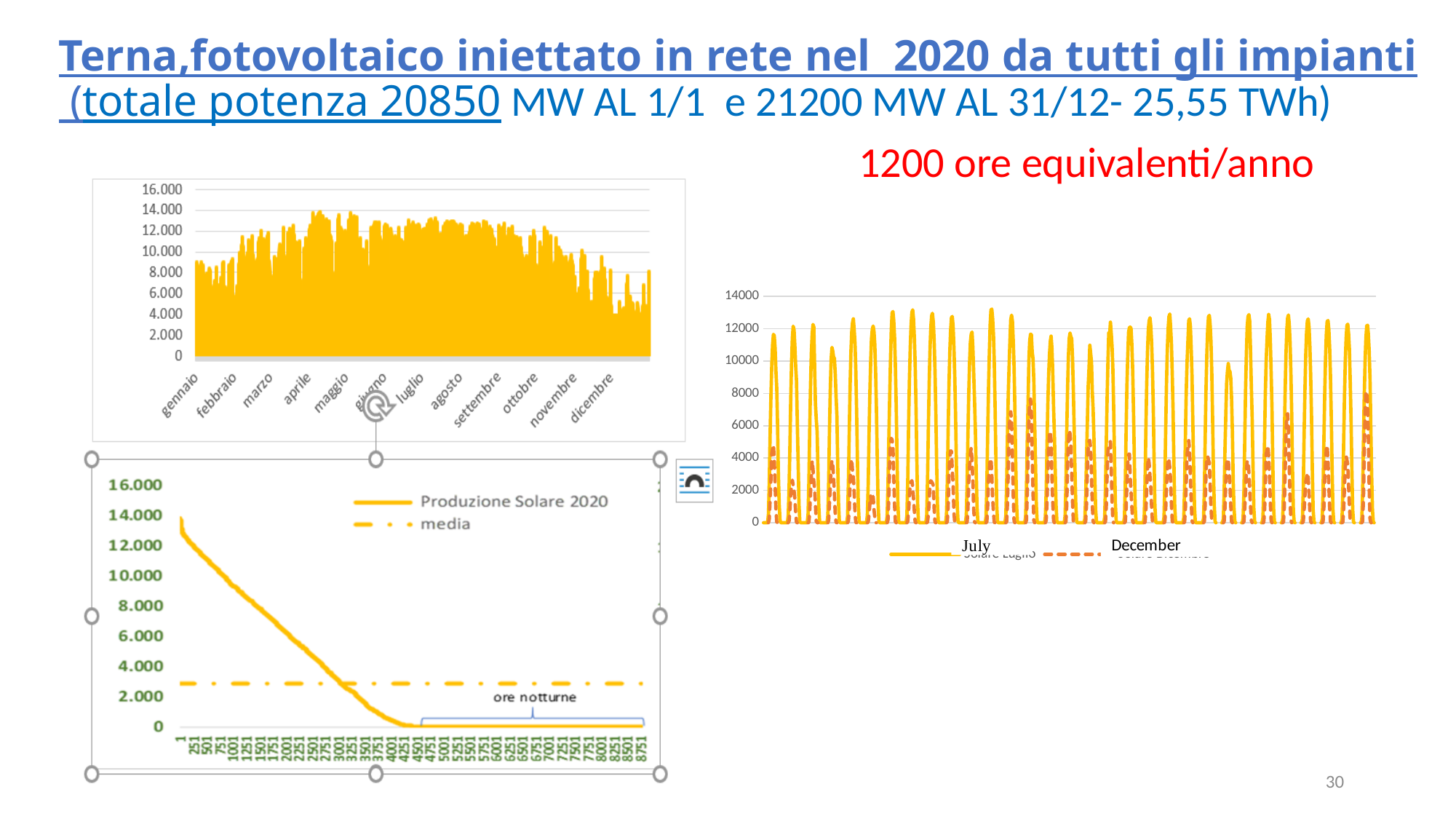
In the bottom-left chart, is the media line greater or less than 4.000? less In the right-hand chart, how many series does the legend list? 2 In the top-left chart, is the production in dicembre greater or less than 10.000? less In the bottom-left chart, is the starting value of Produzione Solare 2020 greater or less than 12.000? greater In the bottom-left chart, does the Produzione Solare 2020 line rise or fall along the x axis? fall In the right-hand chart, which series reaches higher peaks: July or December? July In the top-left chart, how many months are labelled on the x axis? 12 In the top-left chart, which is higher: the production in luglio or in gennaio? luglio In the bottom-left chart, how many series does the legend list? 2 In the bottom-left chart, what are the two series named in the legend? Produzione Solare 2020 and media In the top-left chart, what is the highest value shown on the y axis? 16.000